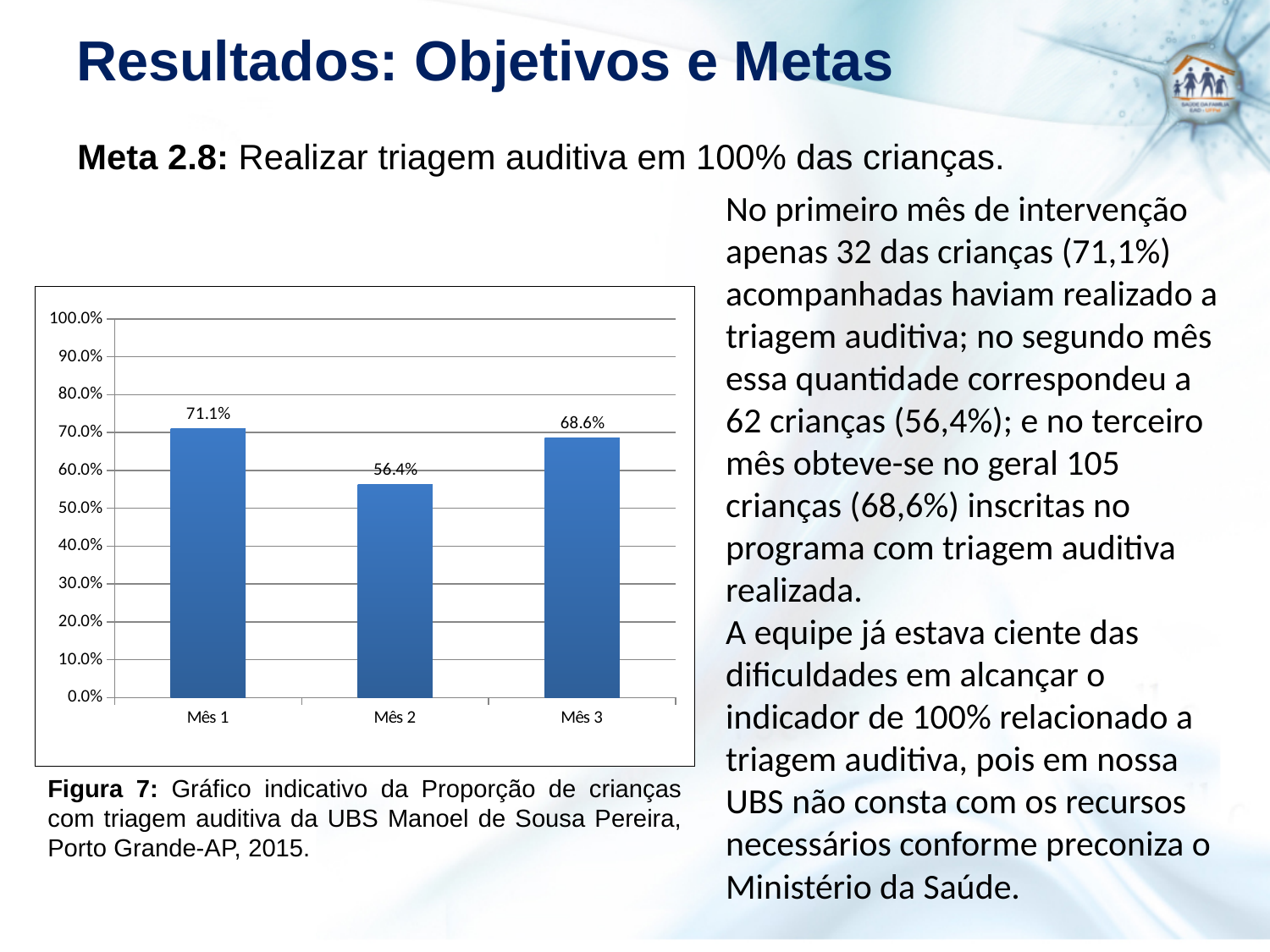
Which month has the lowest value? Mês 2 Is the value for Mês 2 greater or less than 60.0%? less What is the value for Mês 1? 71.1% What is the difference between the values for Mês 1 and Mês 3? 2.5% How many categories are shown on the x axis? 3 What kind of chart is shown on the slide? bar chart What is the figure number given in the caption below the chart? Figura 7 What is the value for Mês 2? 56.4% Which month has the highest value? Mês 1 What is the value for Mês 3? 68.6% What is the difference between the values for Mês 1 and Mês 2? 14.7% Which is larger, the value for Mês 2 or the value for Mês 3? Mês 3